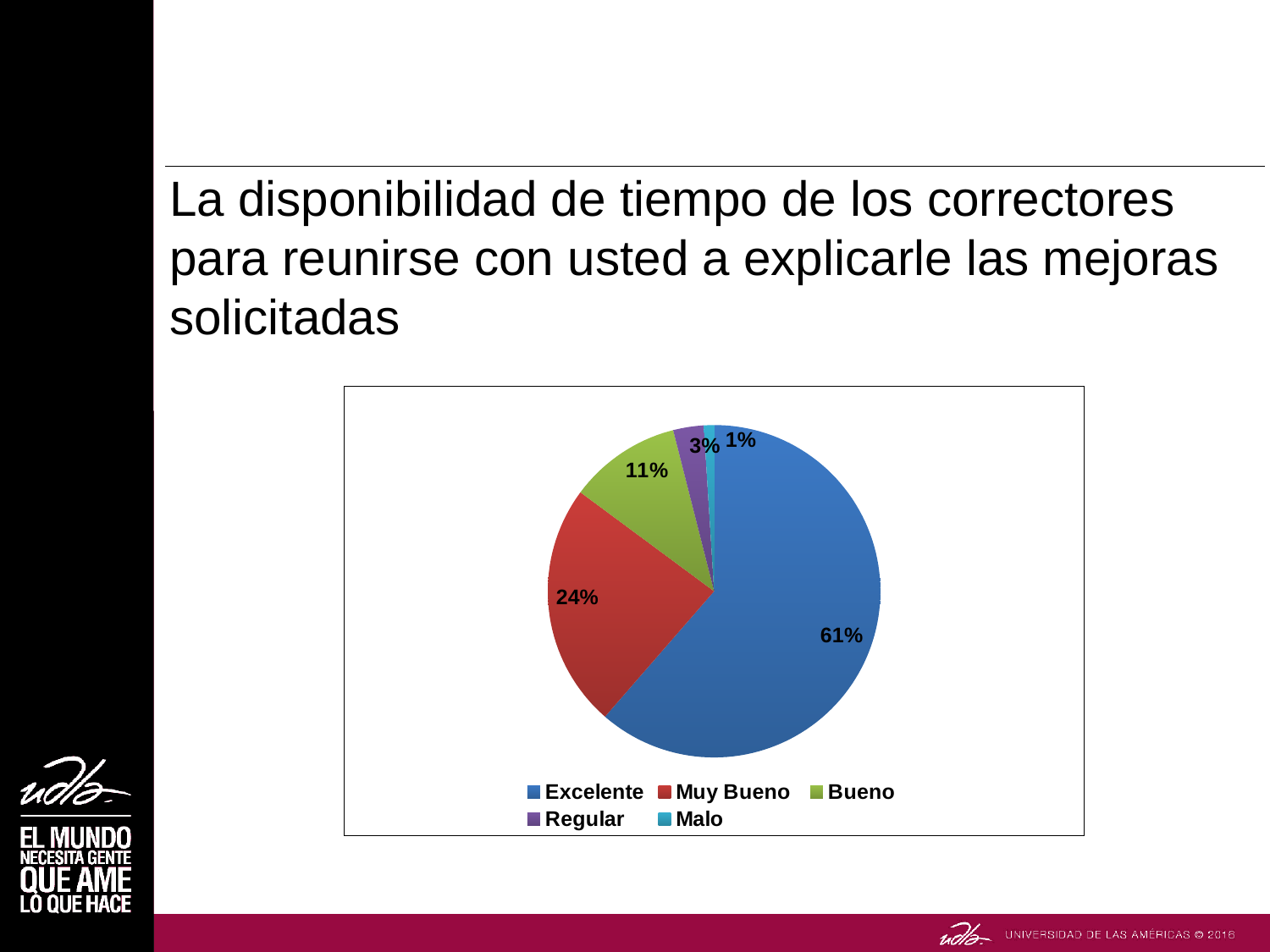
What percentage of responses are 'Regular'? 3% What is the difference in percentage points between 'Excelente' and 'Muy Bueno'? 37 What percentage of responses are 'Malo'? 1% What colour is the 'Muy Bueno' slice? Red How many categories does the pie chart show? 5 Which is larger, the share for 'Bueno' or the share for 'Regular'? Bueno Which category has the largest share of the pie? Excelente Which category has the smallest share of the pie? Malo What percentage of responses are 'Bueno'? 11% What percentage of responses are 'Muy Bueno'? 24% What type of chart is shown on the slide? Pie chart What percentage of responses are 'Excelente'? 61%